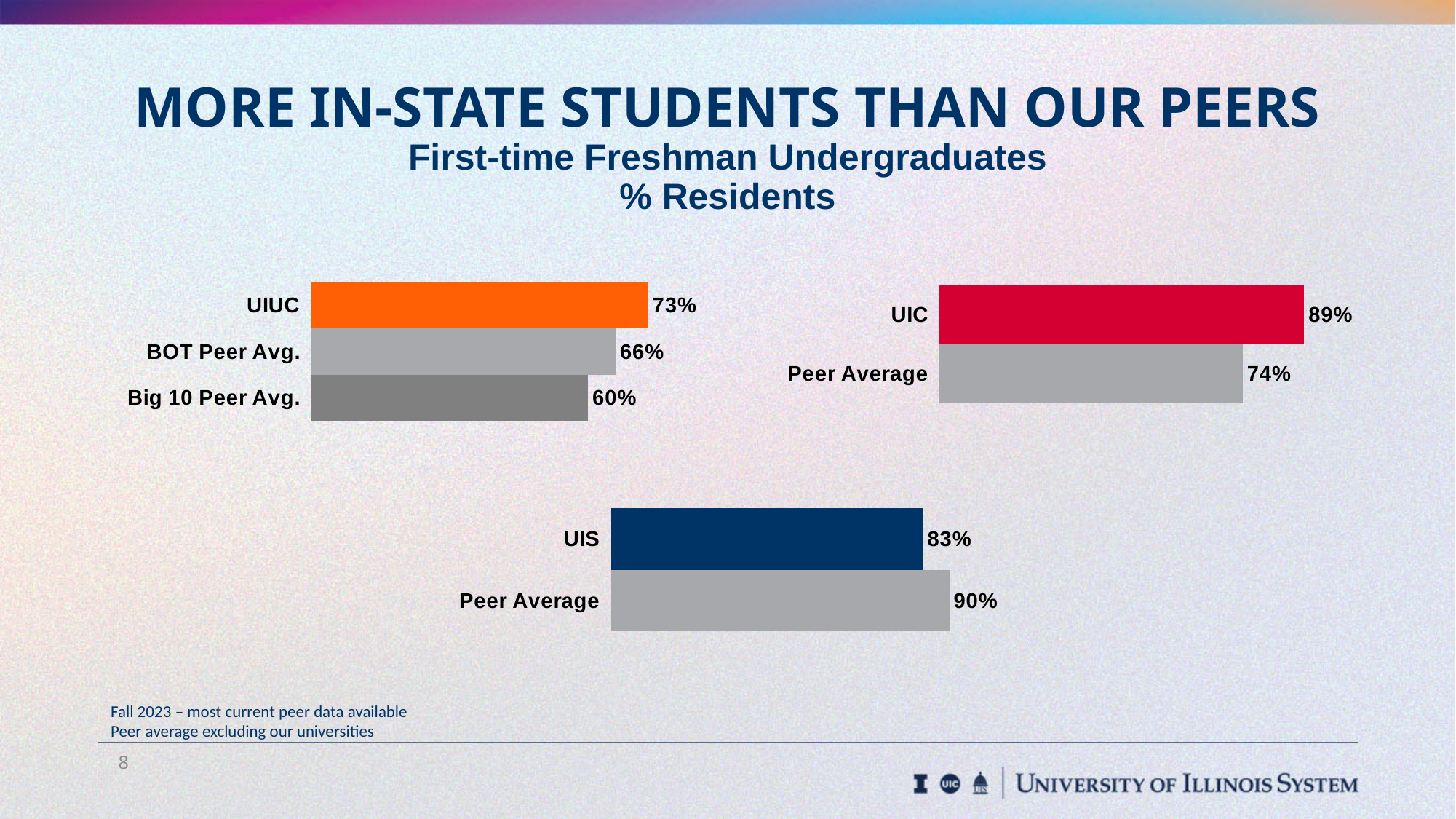
In the top-left chart, what is the value for Big 10 Peer Avg.? 60% In the top-right chart, what is the difference between UIC and Peer Average? 15% What kind of chart is the bottom chart? Bar chart In the bottom chart, what is the value for UIS? 83% In the top-left chart, which category has the lowest value? Big 10 Peer Avg. In the top-right chart, what is the value for UIC? 89% In the top-left chart, what is the value for UIUC? 73% In the top-left chart, what is the difference between UIUC and BOT Peer Avg.? 7% In the bottom chart, which is larger, UIS or Peer Average? Peer Average In the bottom chart, what is the difference between Peer Average and UIS? 7% In the top-left chart, how many bars are shown? 3 In the top-right chart, which is larger, UIC or Peer Average? UIC